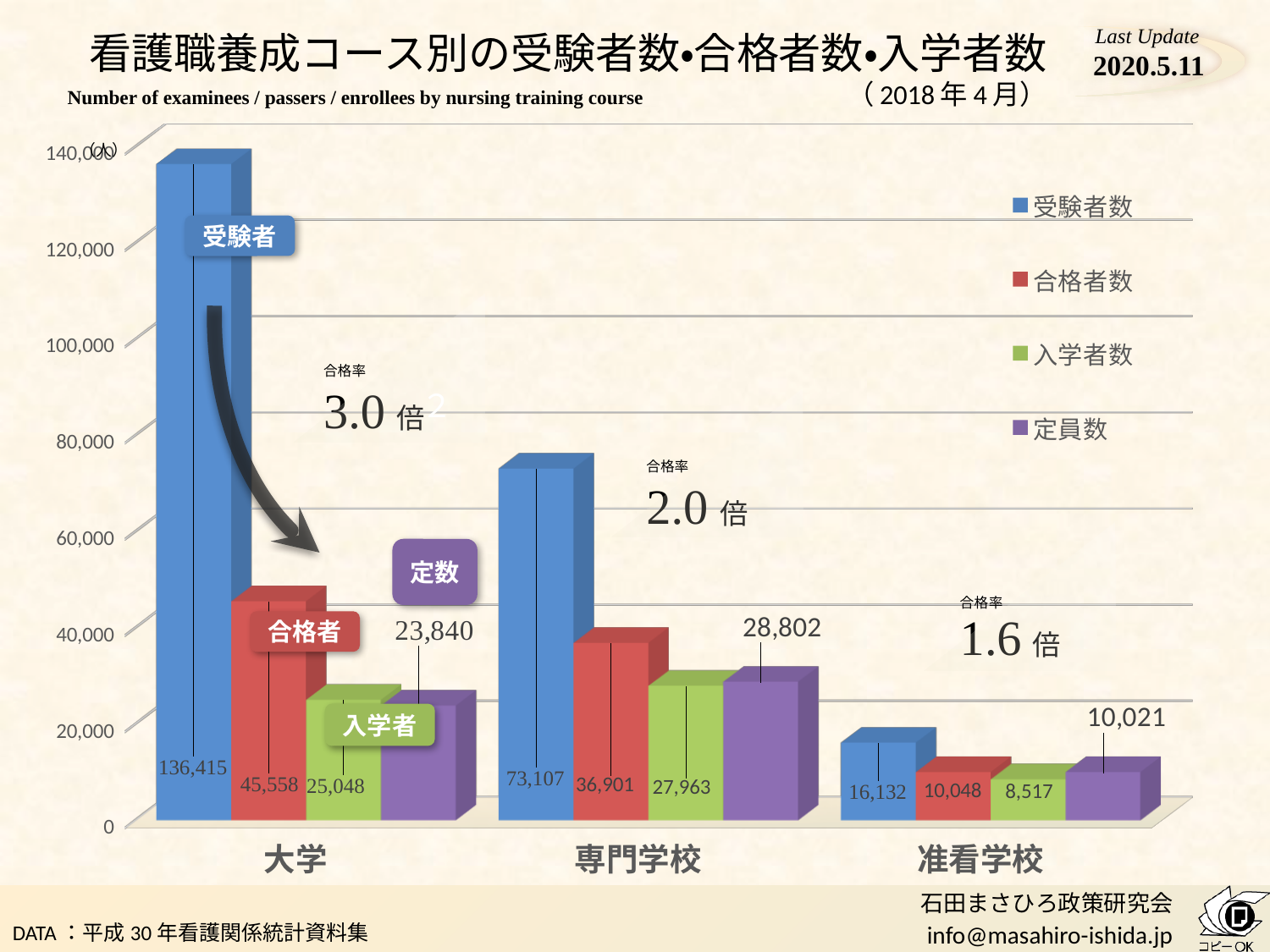
How many series does the legend list? 4 How many categories are shown on the x axis? 3 What is the value of 入学者数 for 准看学校? 8,517 What is the value of 定員数 for 専門学校? 28,802 Which is larger for 准看学校: 入学者数 or 定員数? 定員数 Which category has the lowest 合格者数? 准看学校 What is the value of 合格者数 for 専門学校? 36,901 Which category has the highest 受験者数? 大学 What type of chart is shown on the slide? bar chart What is the difference between 受験者数 and 合格者数 for 大学? 90,857 What 合格率 is shown for 専門学校? 2.0 倍 What is the value of 受験者数 for 大学? 136,415